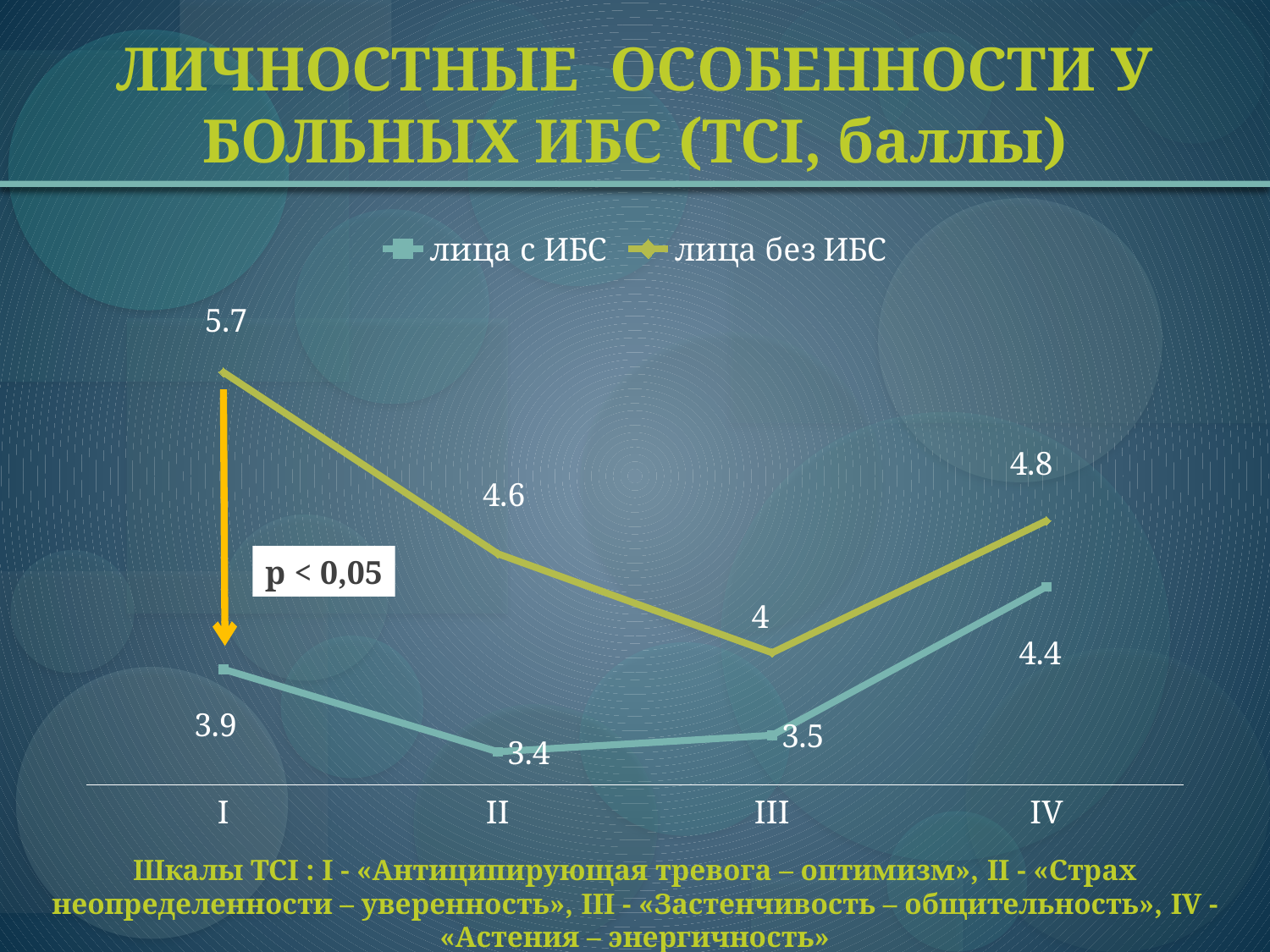
What type of chart is shown on the slide? line chart At which scale is the value for "лица без ИБС" highest? I Which series has the larger value at scale IV, "лица с ИБС" or "лица без ИБС"? лица без ИБС Does the value for "лица без ИБС" rise or fall from scale I to scale III? fall How many categories are shown on the x axis? 4 What is the value for "лица без ИБС" at scale III? 4 What is the value for "лица с ИБС" at scale II? 3.4 What is the difference between "лица без ИБС" and "лица с ИБС" at scale I? 1.8 What is the value for "лица с ИБС" at scale IV? 4.4 What is the value for "лица без ИБС" at scale I? 5.7 At which scale is the value for "лица с ИБС" lowest? II How many series does the legend list? 2